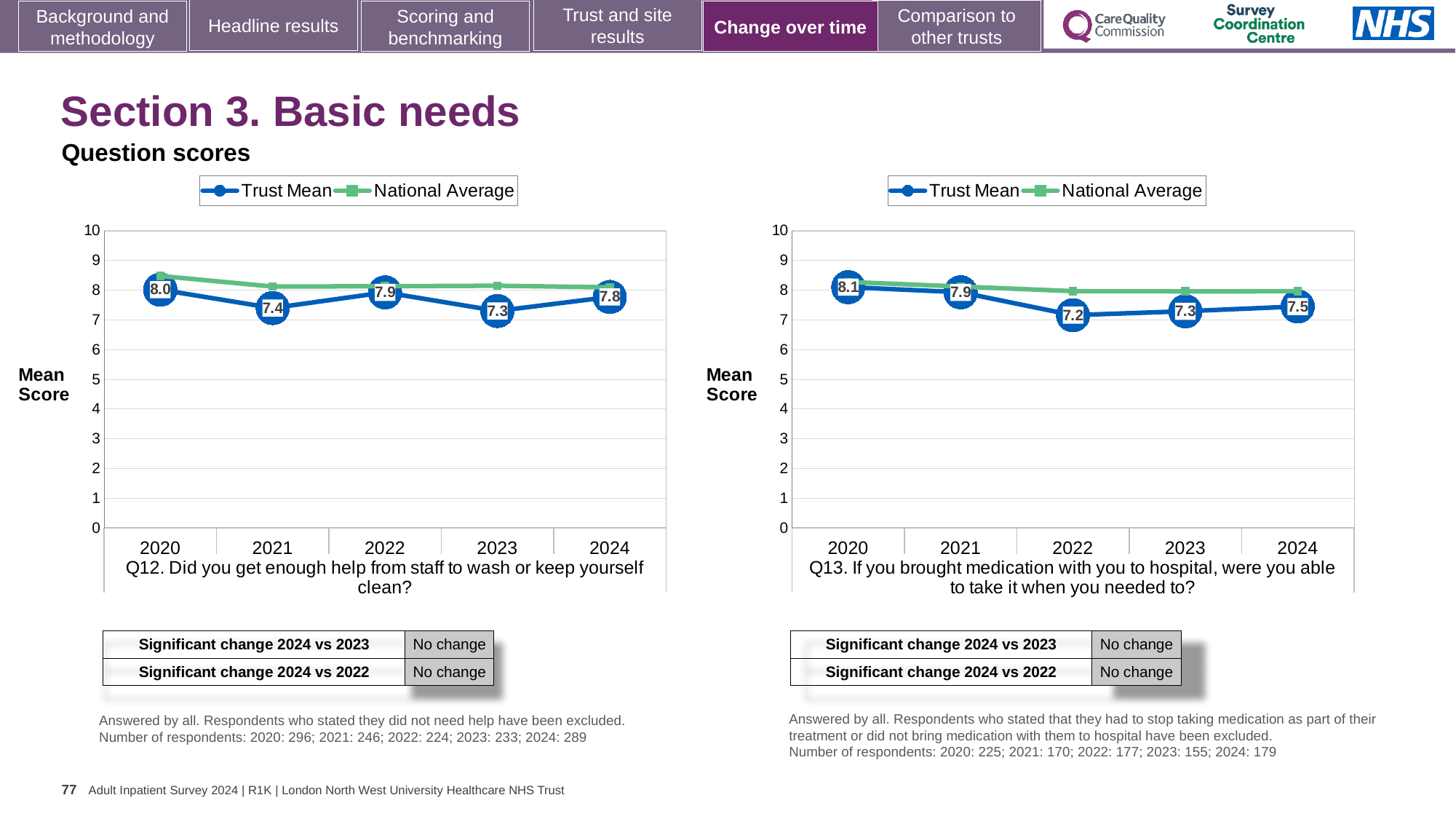
In the Q13 chart (right), which is larger, the Trust Mean score for 2020 or for 2021? 2020 In the Q13 chart (right), what is the Trust Mean score for 2024? 7.5 What type of chart is the Q13 chart (right)? Line chart In the Q13 chart (right), which year has the lowest Trust Mean score? 2022 In the Q12 chart (left), what is the difference between the Trust Mean scores for 2022 and 2023? 0.6 In the Q12 chart (left), which year has the highest Trust Mean score? 2020 In the Q12 chart (left), what is the Trust Mean score for 2020? 8.0 In the Q13 chart (right), what is the Trust Mean score for 2022? 7.2 How many years are plotted on the x axis of the Q13 chart (right)? 5 How many series does the legend of the Q12 chart (left) list? 2 In the Q12 chart (left), is the National Average for 2020 greater or less than 8? greater In the Q12 chart (left), what is the Trust Mean score for 2023? 7.3